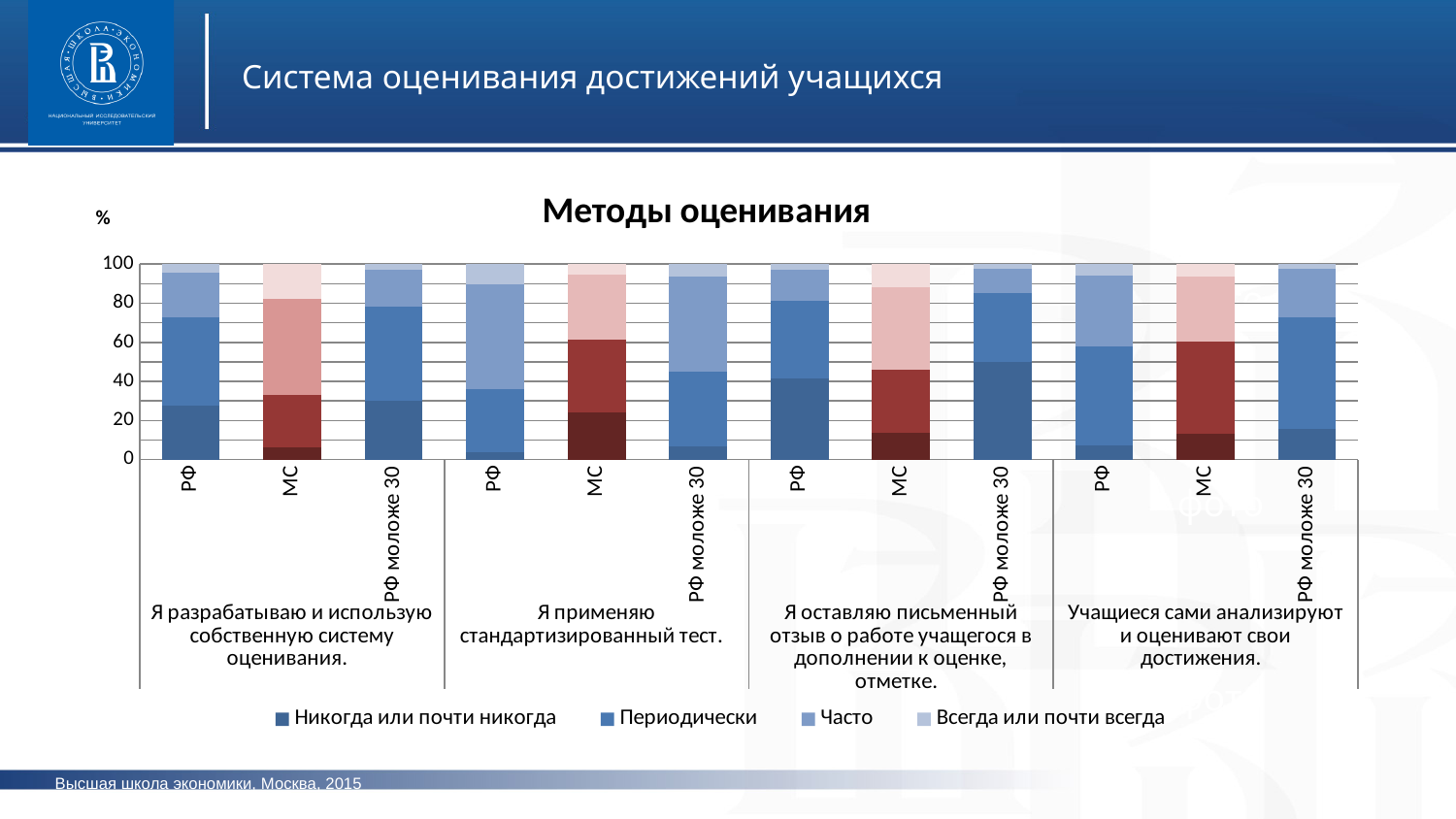
What kind of chart is shown on the slide? Stacked bar chart In the group 'Я применяю стандартизированный тест', is the 'Никогда или почти никогда' segment for РФ greater or less than 20? less What is the title of the chart? Методы оценивания In the group 'Я разрабатываю и использую собственную систему оценивания', is the 'Никогда или почти никогда' segment for МС greater or less than 20? less In the group 'Я оставляю письменный отзыв о работе учащегося в дополнении к оценке, отметке', is the 'Никогда или почти никогда' segment for РФ greater or less than 20? greater What unit is shown on the y axis? % How many bars are plotted in the chart in total? 12 In the group 'Я оставляю письменный отзыв о работе учащегося в дополнении к оценке, отметке', which has the larger 'Никогда или почти никогда' segment, РФ or МС? РФ How many series does the legend list? 4 How many assessment-method groups are shown along the x axis? 4